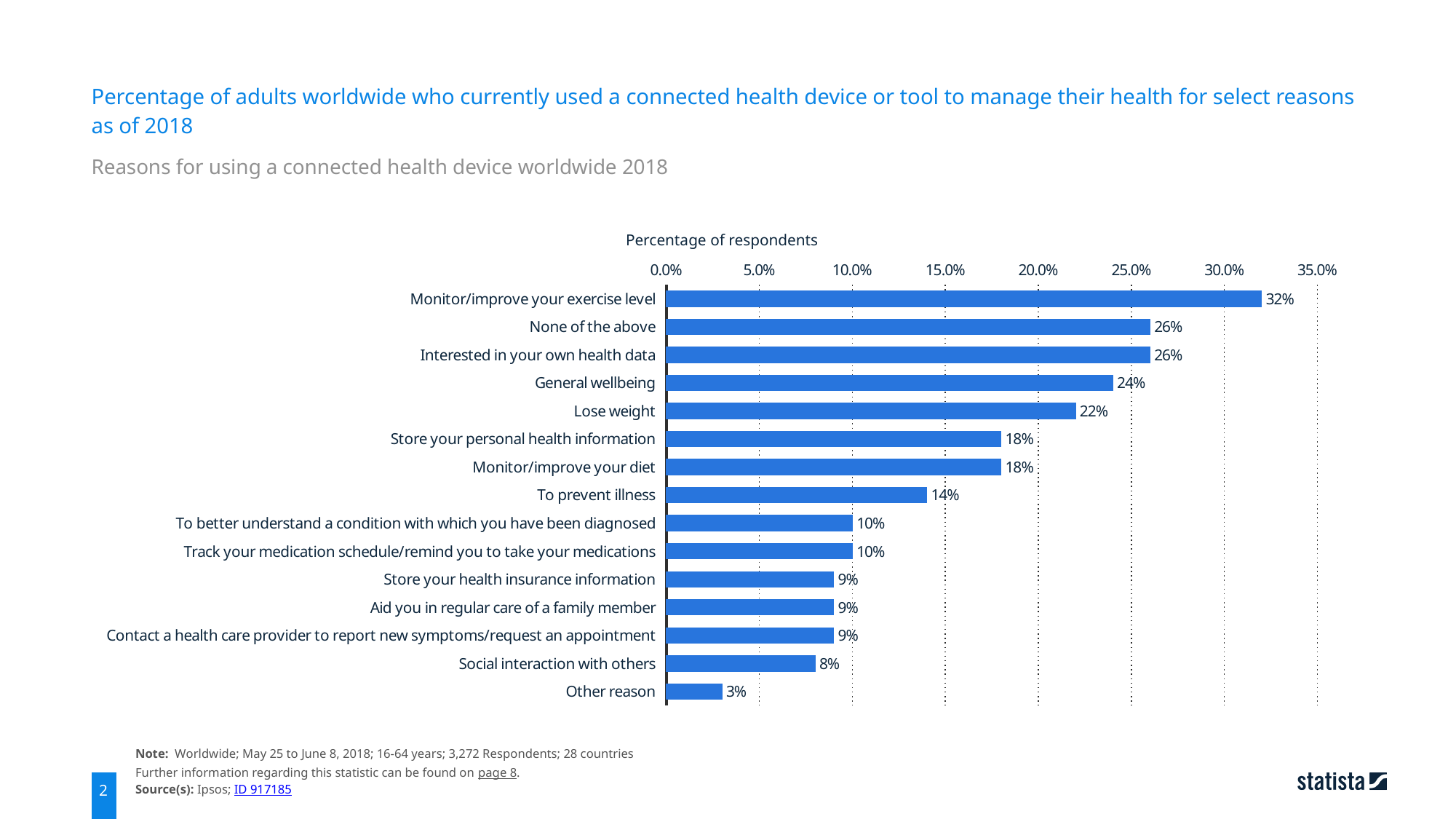
Which reason has the lowest percentage of respondents? Other reason What type of chart is shown on the slide? Bar chart How many reasons (categories) are shown in the chart? 15 What is the label of the horizontal axis of the chart? Percentage of respondents Which reason has the highest percentage of respondents? Monitor/improve your exercise level What percentage of respondents used a connected health device to lose weight? 22% Which has a higher percentage: 'Lose weight' or 'To prevent illness'? Lose weight What percentage of respondents used a connected health device to monitor/improve their exercise level? 32% What percentage of respondents selected 'Other reason'? 3% What percentage of respondents used a connected health device for social interaction with others? 8% What is the difference in percentage points between 'To prevent illness' and 'Social interaction with others'? 6 What is the difference in percentage points between 'Monitor/improve your exercise level' and 'General wellbeing'? 8